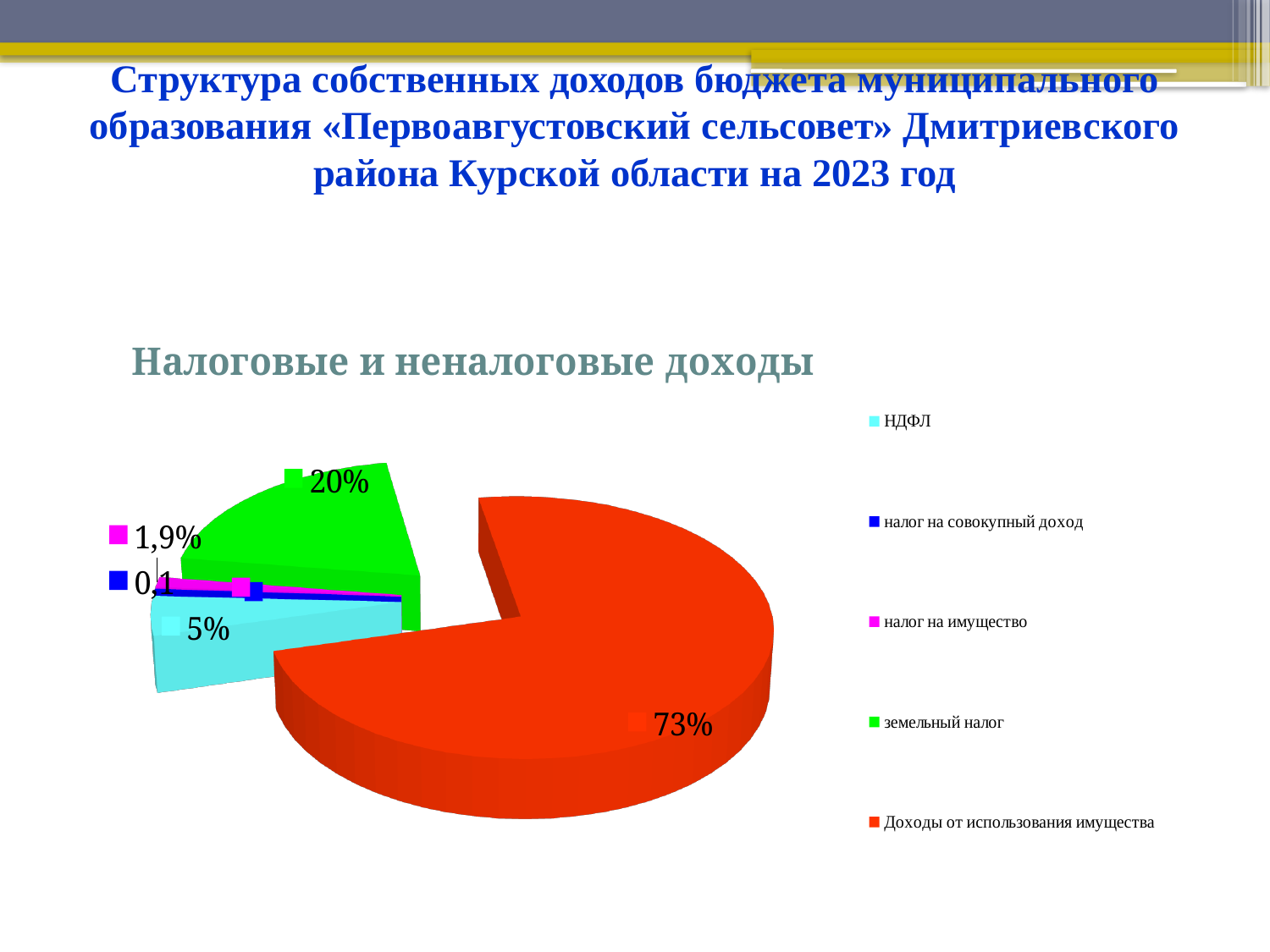
What value is labelled for налог на совокупный доход? 0,1 What share of the pie is labelled for Доходы от использования имущества? 73% How many categories does the legend of the pie chart list? 5 What share of the pie is labelled for НДФЛ? 5% What is the difference between the share for Доходы от использования имущества and the share for земельный налог? 53% What share of the pie is labelled for земельный налог? 20% Which category has the largest slice of the pie? Доходы от использования имущества Which category has the smallest slice of the pie? налог на совокупный доход Which is larger, the slice for земельный налог or the slice for НДФЛ? земельный налог What value is labelled for налог на имущество? 1,9% What kind of chart is shown on the slide? pie chart What is the title of the chart? Налоговые и неналоговые доходы